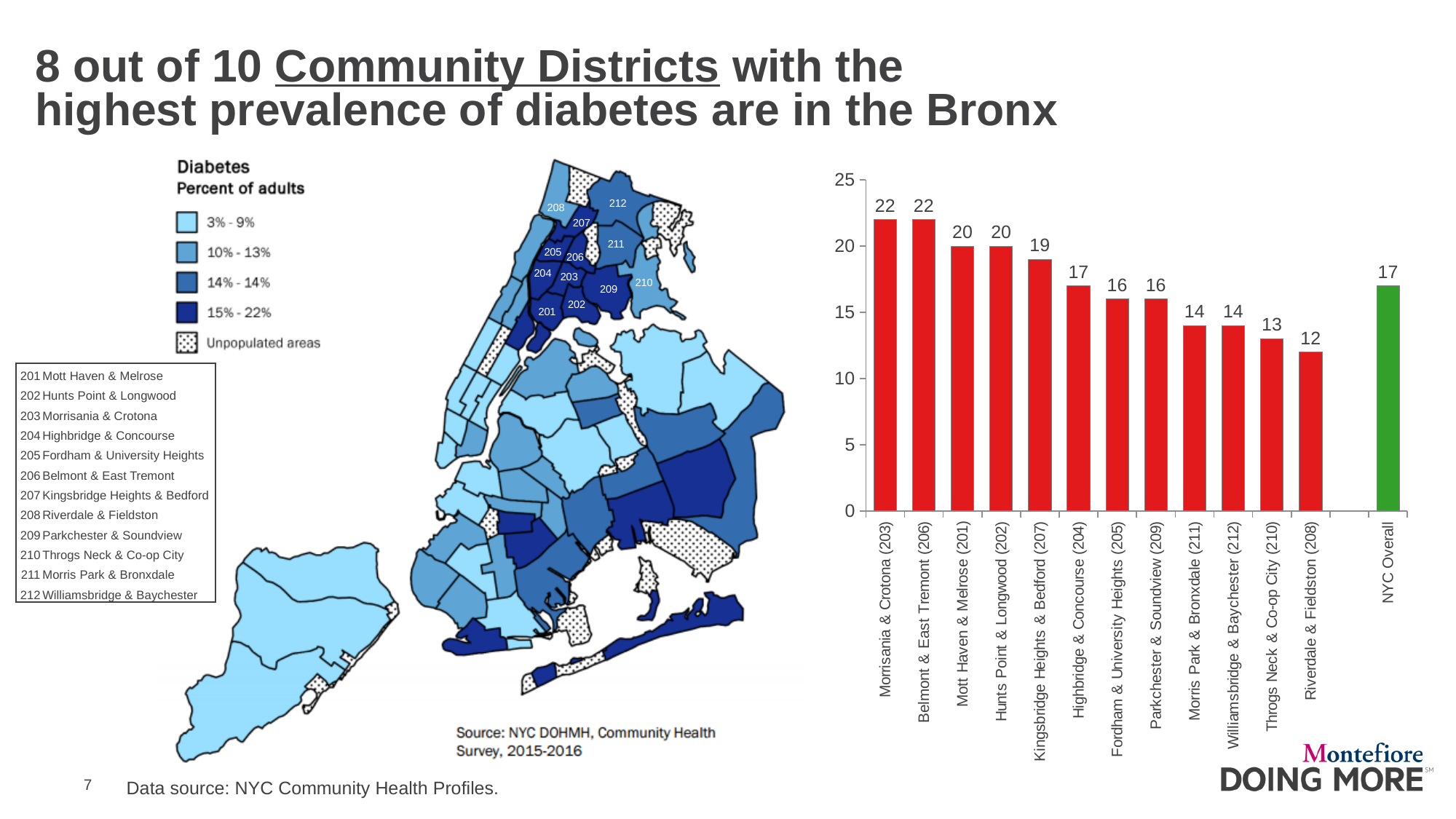
In the bar chart, what is the value for Throgs Neck & Co-op City (210)? 13 How many bars are shown in the bar chart? 13 In the bar chart, what is the difference between the value for Morrisania & Crotona (203) and the value for NYC Overall? 5 In the bar chart, do the community district values rise or fall from left to right? fall In the bar chart, what is the value for NYC Overall? 17 In the bar chart, which is larger: the value for Kingsbridge Heights & Bedford (207) or the value for Highbridge & Concourse (204)? Kingsbridge Heights & Bedford (207) In the bar chart, what is the difference between the value for Highbridge & Concourse (204) and the value for Riverdale & Fieldston (208)? 5 What kind of chart is shown on the right side of the slide? bar chart In the bar chart, what colour is the NYC Overall bar? green In the bar chart, which community district has the lowest value? Riverdale & Fieldston (208) In the bar chart, is the value for Riverdale & Fieldston (208) greater or less than 15? less In the bar chart, what is the value for Kingsbridge Heights & Bedford (207)? 19